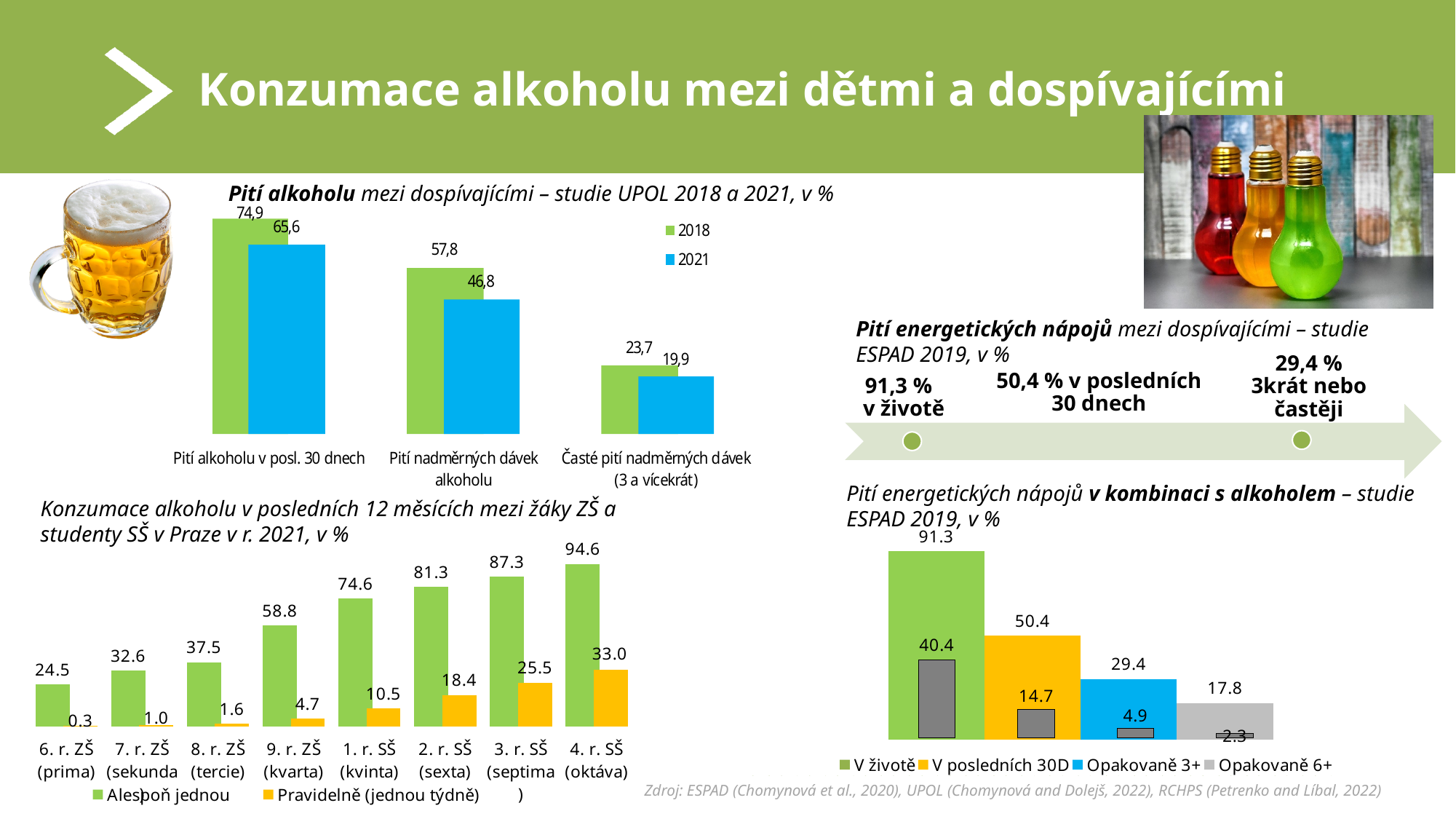
In the bottom-left chart 'Konzumace alkoholu v posledních 12 měsících', what is the 'Alespoň jednou' value for 9. r. ZŠ (kvarta)? 58.8 In the bottom-left chart 'Konzumace alkoholu v posledních 12 měsících', how many grade categories are shown on the x axis? 8 In the bottom-left chart 'Konzumace alkoholu v posledních 12 měsících', do the 'Alespoň jednou' values rise or fall from 6. r. ZŠ to 4. r. SŠ? rise What kind of chart is the bottom-right chart 'Pití energetických nápojů v kombinaci s alkoholem'? bar chart In the top-left chart 'Pití alkoholu mezi dospívajícími', what is the 2021 value for 'Pití nadměrných dávek alkoholu'? 46,8 In the top-left chart 'Pití alkoholu mezi dospívajícími', what is the 2018 value for 'Pití alkoholu v posl. 30 dnech'? 74,9 In the bottom-left chart 'Konzumace alkoholu v posledních 12 měsících', what is the 'Pravidelně (jednou týdně)' value for 4. r. SŠ (oktáva)? 33.0 In the top-left chart 'Pití alkoholu mezi dospívajícími', by how much did 'Pití alkoholu v posl. 30 dnech' fall from 2018 to 2021? 9,3 In the bottom-right chart 'Pití energetických nápojů v kombinaci s alkoholem', what is the value for 'Opakovaně 3+'? 4.9 In the top-left chart 'Pití alkoholu mezi dospívajícími', which category has the lowest 2021 value? Časté pití nadměrných dávek (3 a vícekrát) In the bottom-left chart 'Konzumace alkoholu v posledních 12 měsících', what is the difference between 'Alespoň jednou' and 'Pravidelně (jednou týdně)' for 2. r. SŠ (sexta)? 62.9 In the top-left chart 'Pití alkoholu mezi dospívajícími', how many series does the legend list? 2